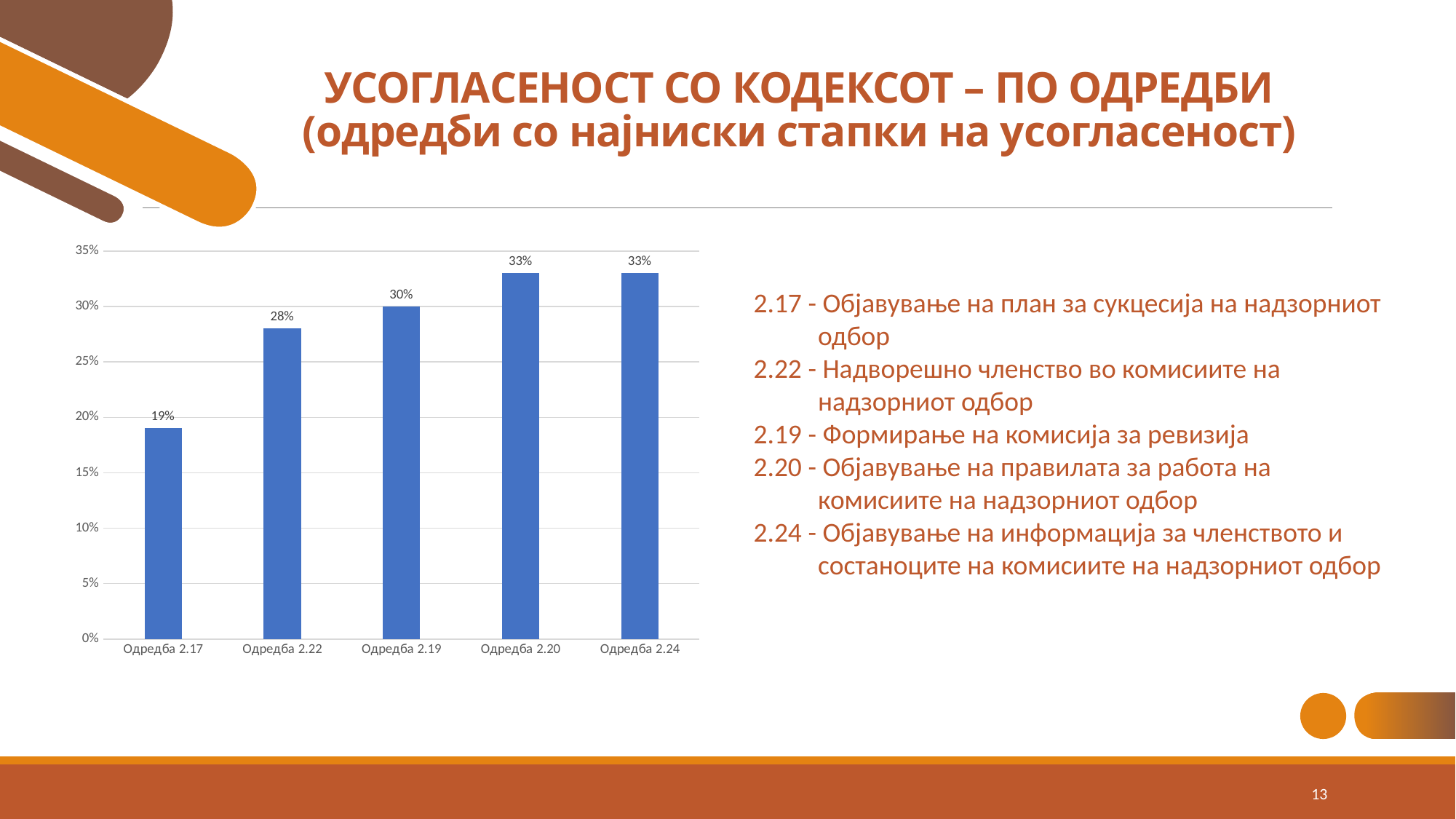
What is the value for Одредба 2.17? 19% What is the value for Одредба 2.20? 33% What is the difference between the values for Одредба 2.19 and Одредба 2.17? 11% Is the value for Одредба 2.17 greater or less than 20%? less What is the difference between the values for Одредба 2.24 and Одредба 2.22? 5% Which is larger, the value for Одредба 2.22 or the value for Одредба 2.19? Одредба 2.19 Do the values rise or fall from left to right along the x axis? rise What kind of chart is shown on the slide? bar chart How many categories are shown on the x axis? 5 Which category has the lowest value? Одредба 2.17 What is the value for Одредба 2.22? 28% What is the value for Одредба 2.19? 30%